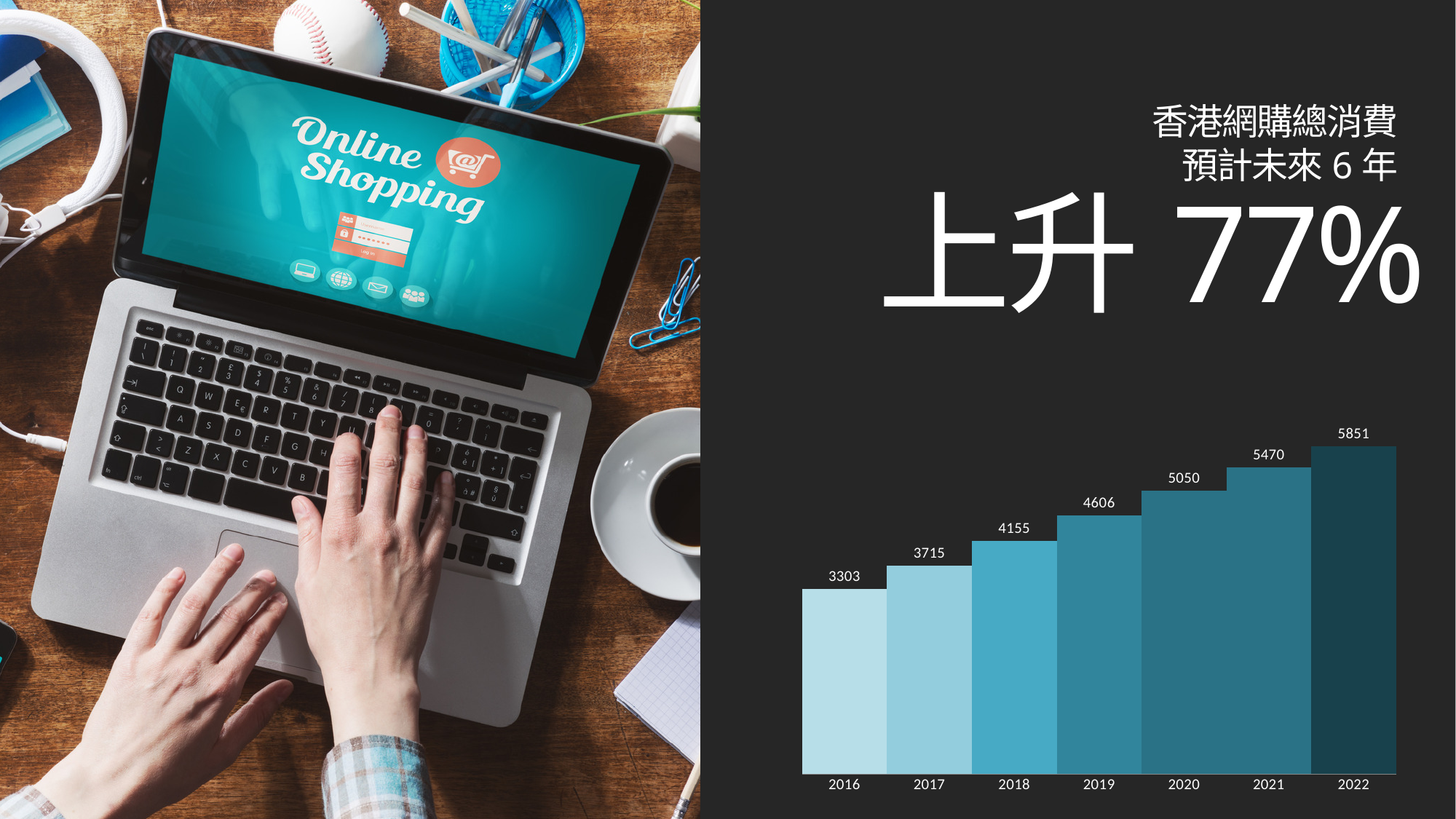
What is the value for 2022? 5851 Do the values rise or fall from 2016 to 2022? rise What is the value for 2016? 3303 Which year has the highest value? 2022 What percentage increase is highlighted in the large text above the chart? 77% What is the difference between the values for 2022 and 2016? 2548 Which year has the lowest value? 2016 What is the value for 2019? 4606 Which is larger, the value for 2018 or the value for 2017? 2018 What is the difference between the values for 2021 and 2020? 420 What kind of chart is shown on the slide? bar chart How many years are shown on the x axis? 7